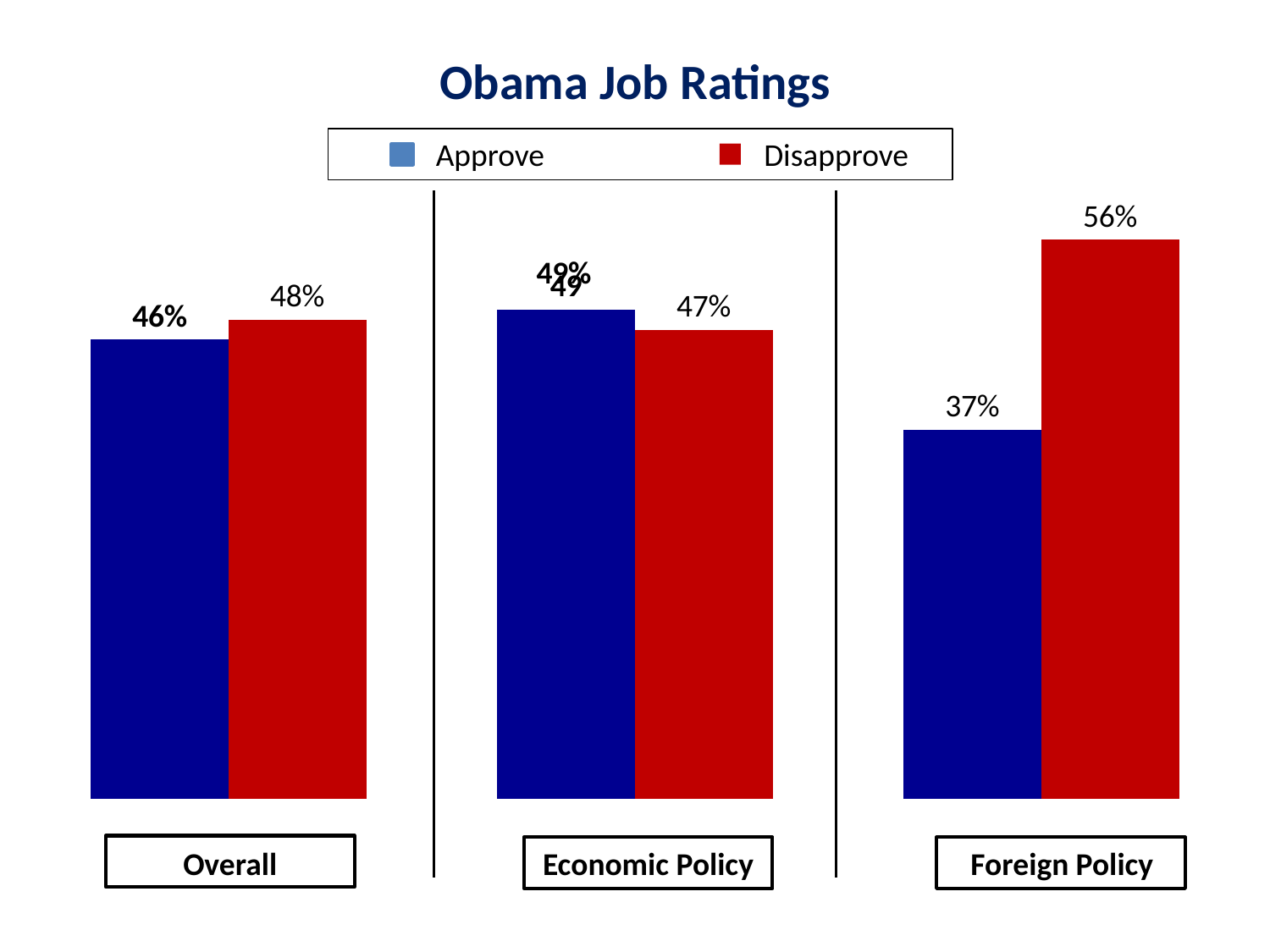
Which category has the lowest Approve value? Foreign Policy How many categories are shown on the chart? 3 What is the Disapprove value for Overall? 48% What is the Disapprove value for Economic Policy? 47% How many series does the legend list? 2 For Foreign Policy, how much higher is the Disapprove value than the Approve value? 19 percentage points What is the Approve value for Foreign Policy? 37% What is the Disapprove value for Foreign Policy? 56% What is the Approve value for Overall? 46% Which category has the highest Disapprove value? Foreign Policy For Overall, which is larger: Approve or Disapprove? Disapprove What kind of chart is shown on the slide? Bar chart